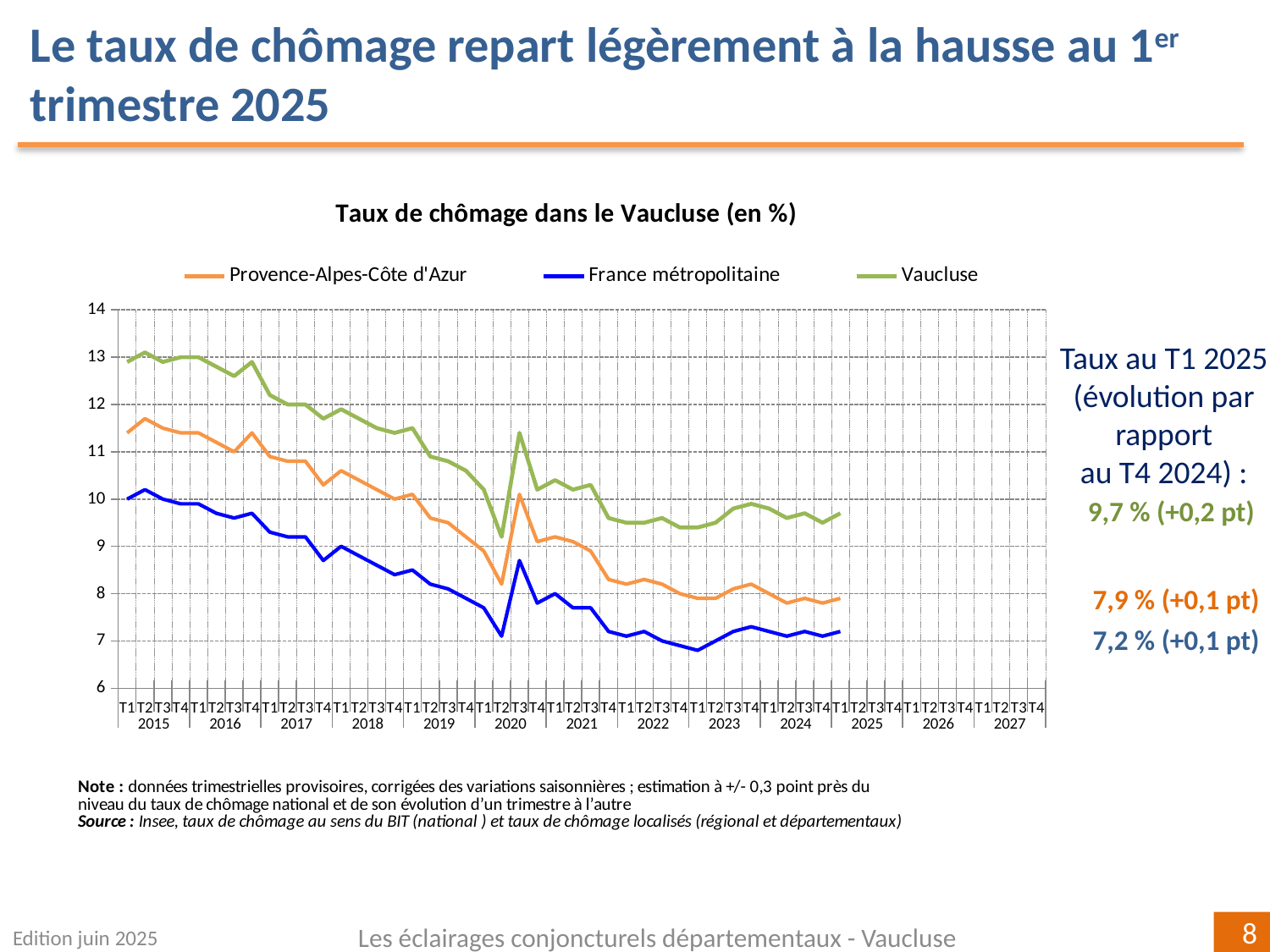
What is the unemployment rate for France métropolitaine at T1 2025? 7,2 % What is the unemployment rate for Provence-Alpes-Côte d'Azur at T1 2025? 7,9 % What kind of chart is shown on the slide? line chart At T1 2025, how much higher is the Vaucluse rate than the France métropolitaine rate? 2,5 points What is the title of the chart? Taux de chômage dans le Vaucluse (en %) What is the unemployment rate for Vaucluse at T1 2025? 9,7 % How many series does the legend of the chart list? 3 Is the value for France métropolitaine at T1 2015 greater or less than 9? greater Which series has the highest values across the whole period shown? Vaucluse At T1 2025, which is higher: the rate for Provence-Alpes-Côte d'Azur or for France métropolitaine? Provence-Alpes-Côte d'Azur Overall, does the Vaucluse line rise or fall between 2015 and 2024? fall Is the value for Vaucluse at T1 2015 greater or less than 12? greater